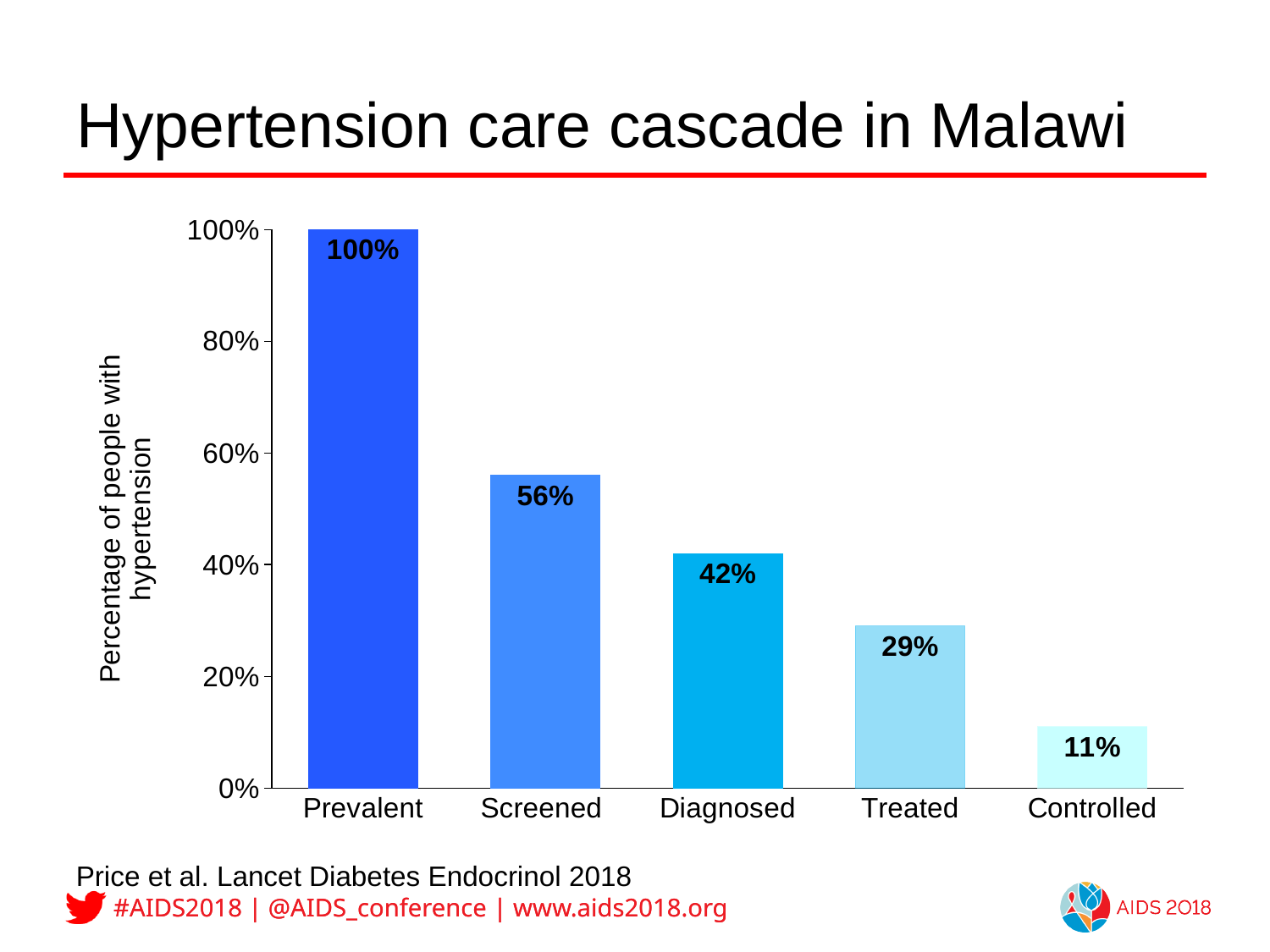
What is the difference between the values for Screened and Diagnosed? 14% Which category has the lowest value? Controlled What is the value for Controlled? 11% Do the values rise or fall from Prevalent to Controlled? Fall How many categories are shown on the x axis? 5 What is the difference between the values for Treated and Controlled? 18% What is the value for Screened? 56% What is the title of the chart? Hypertension care cascade in Malawi What is the value for Treated? 29% What kind of chart is shown on the slide? Bar chart Which is larger, the value for Diagnosed or the value for Treated? Diagnosed Which category has the highest value? Prevalent